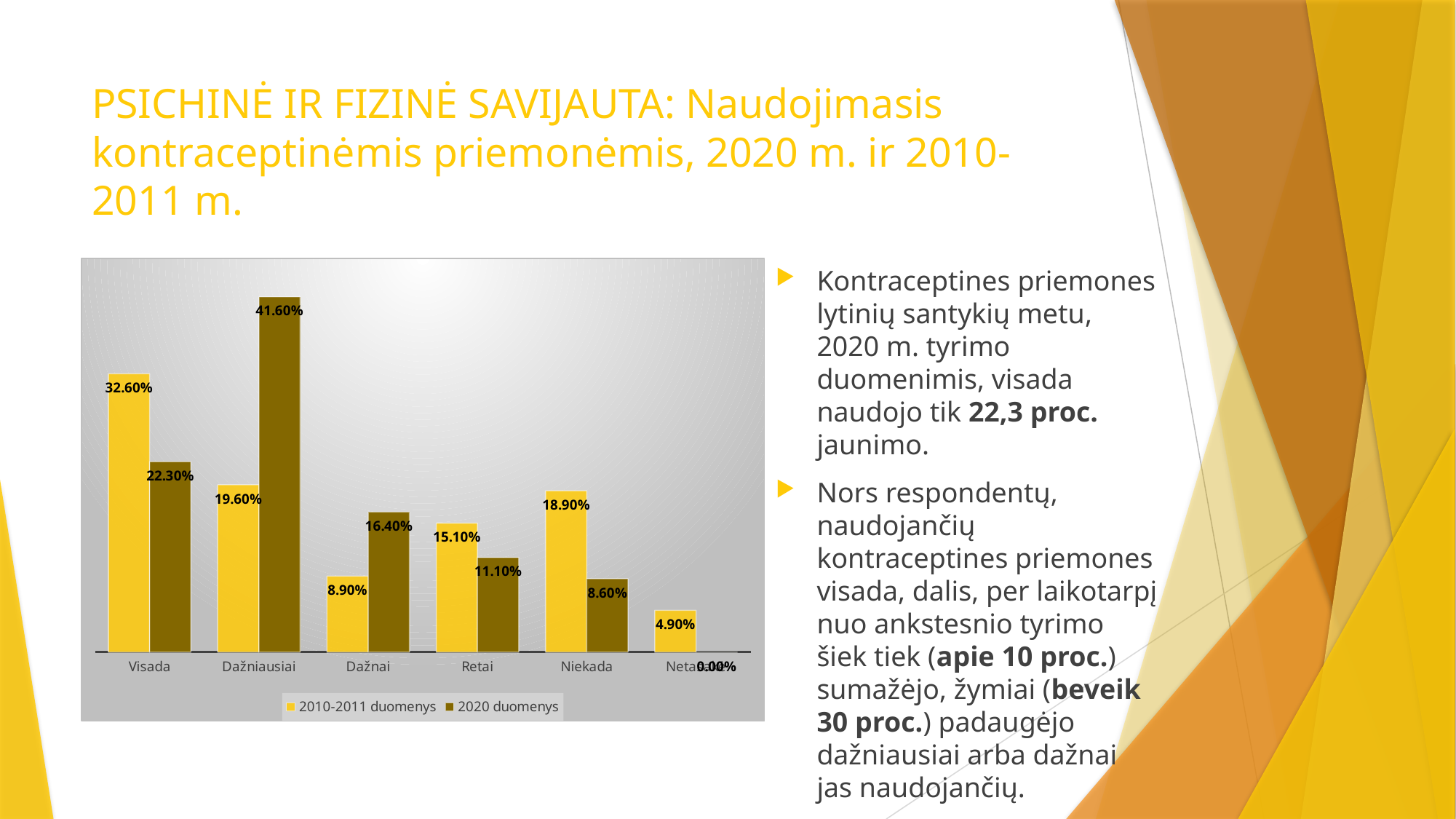
What is the 2020 duomenys value for Niekada? 8.60% What is the 2010-2011 duomenys value for Visada? 32.60% For Retai, which series has the larger value: 2010-2011 duomenys or 2020 duomenys? 2010-2011 duomenys Which category has the highest 2010-2011 duomenys value? Visada What is the difference between the 2020 duomenys and 2010-2011 duomenys values for Dažniausiai? 22.00% For Dažnai, which series has the larger value: 2010-2011 duomenys or 2020 duomenys? 2020 duomenys What is the 2020 duomenys value for Dažniausiai? 41.60% What is the 2010-2011 duomenys value for Retai? 15.10% What is the difference between the 2010-2011 duomenys and 2020 duomenys values for Visada? 10.30% How many series does the legend list? 2 Which category has the highest 2020 duomenys value? Dažniausiai What kind of chart is shown on the slide? Bar chart